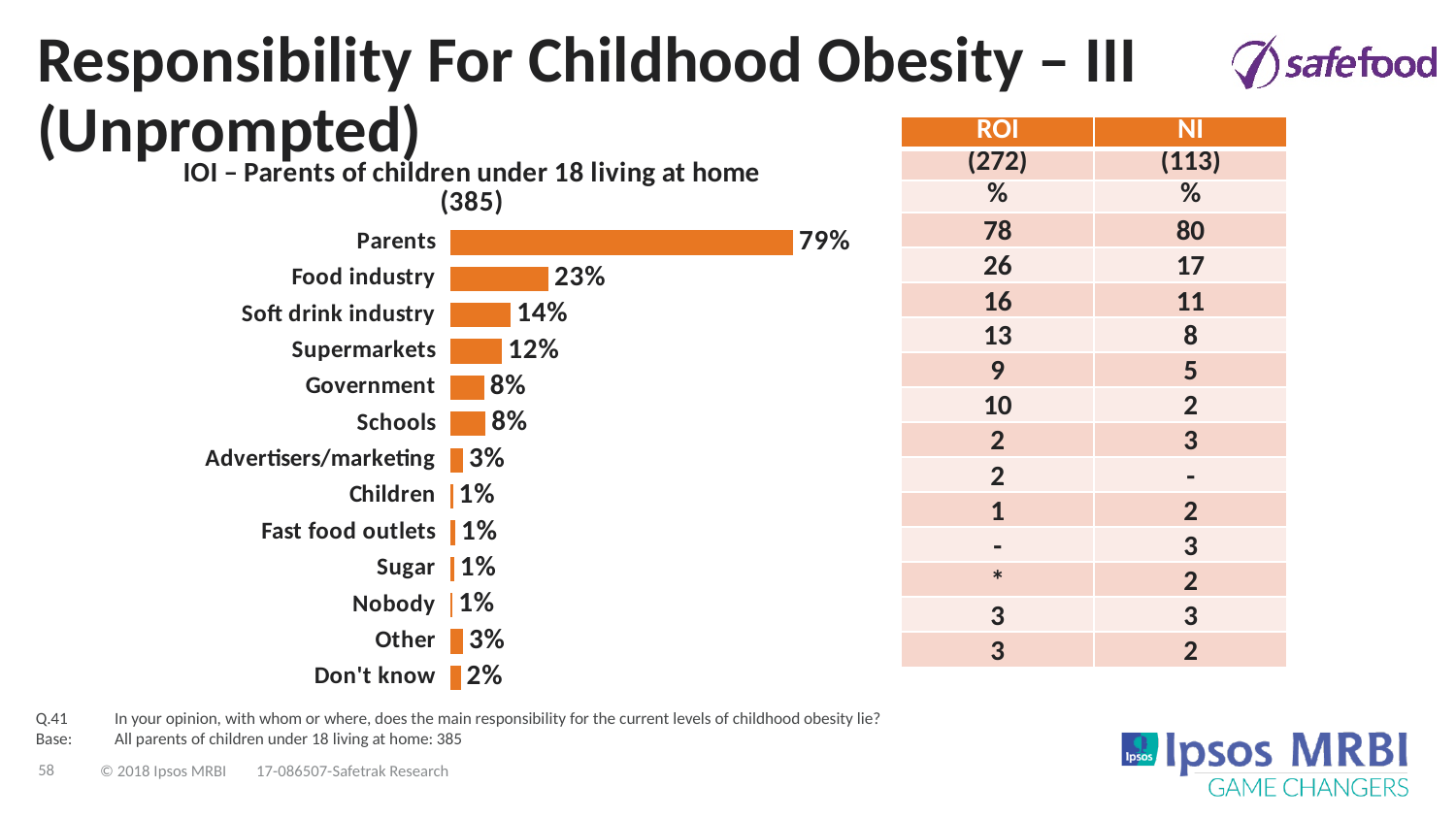
What percentage of parents said Parents are responsible for childhood obesity? 79% Which is larger, the value for Government or the value for Advertisers/marketing? Government How many categories are shown in the bar chart? 13 What is the value shown for Food industry? 23% What is the difference between the values for Soft drink industry and Supermarkets? 2% What is the value shown for Soft drink industry? 14% What is the difference between the values for Parents and Food industry? 56% Which category has the highest value in the bar chart? Parents What is the value shown for Supermarkets? 12% What is the title of the bar chart? IOI – Parents of children under 18 living at home (385) What is the value shown for Don't know? 2% What kind of chart is shown on the slide? Bar chart